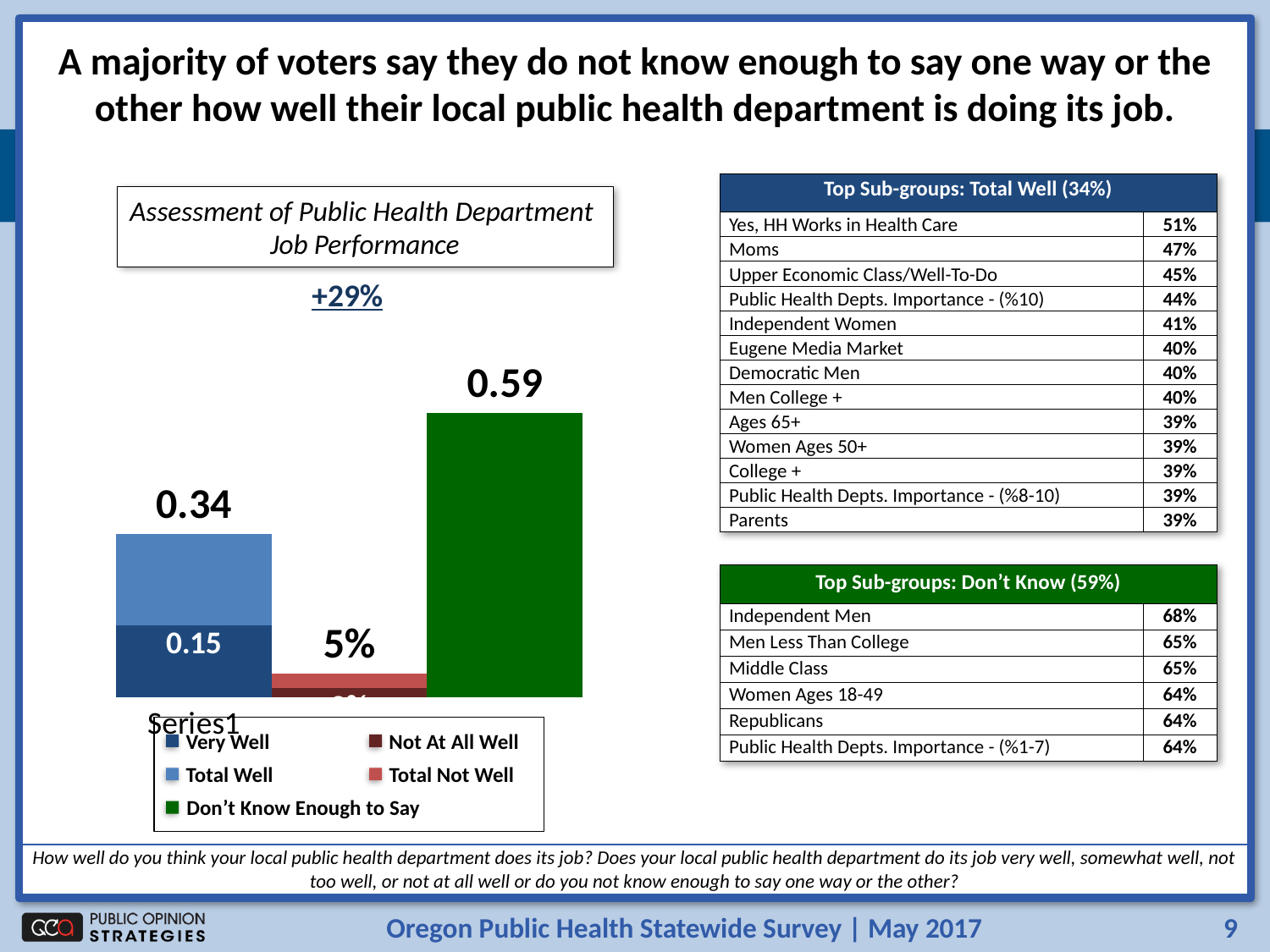
What is the value shown for Total Not Well? 5% Which legend entry is shown in green? Don't Know Enough to Say What difference is annotated above the chart with a plus sign? +29% What is the value shown for Total Well? 0.34 Which is larger, the value for Total Well or the value for Don't Know Enough to Say? Don't Know Enough to Say What kind of chart is shown on the slide? bar chart How many series does the chart's legend list? 5 What is the title of the chart on the slide? Assessment of Public Health Department Job Performance What is the difference between the Don't Know Enough to Say value (0.59) and the Total Well value (0.34)? 0.25 What is the value shown for Don't Know Enough to Say? 0.59 What is the value shown for Very Well? 0.15 Which series has the highest value in the chart? Don't Know Enough to Say